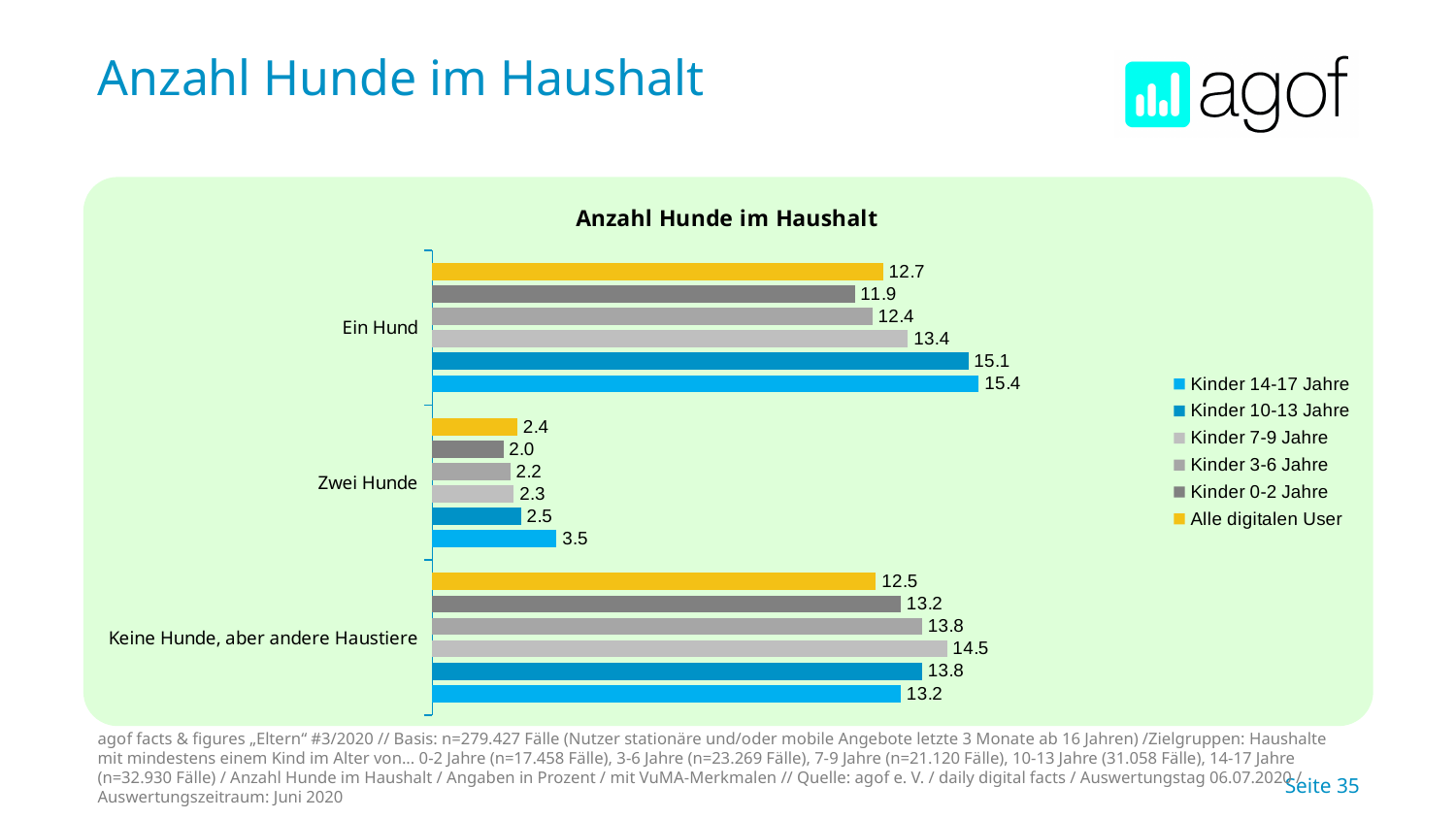
What is the value for Kinder 14-17 Jahre in the Zwei Hunde category? 3.5 Which series has the highest value in the Ein Hund category? Kinder 14-17 Jahre What is the value for Kinder 0-2 Jahre in the Ein Hund category? 11.9 What is the value for Alle digitalen User in the Ein Hund category? 12.7 Which series has the lowest value in the Zwei Hunde category? Kinder 0-2 Jahre What is the difference between Kinder 14-17 Jahre and Alle digitalen User in the Ein Hund category? 2.7 What is the value for Kinder 10-13 Jahre in the Keine Hunde, aber andere Haustiere category? 13.8 How many series does the legend list? 6 How many categories are shown on the vertical axis? 3 In the Keine Hunde, aber andere Haustiere category, which is larger: Kinder 7-9 Jahre or Alle digitalen User? Kinder 7-9 Jahre What is the title of the chart? Anzahl Hunde im Haushalt What type of chart is shown on the slide? bar chart